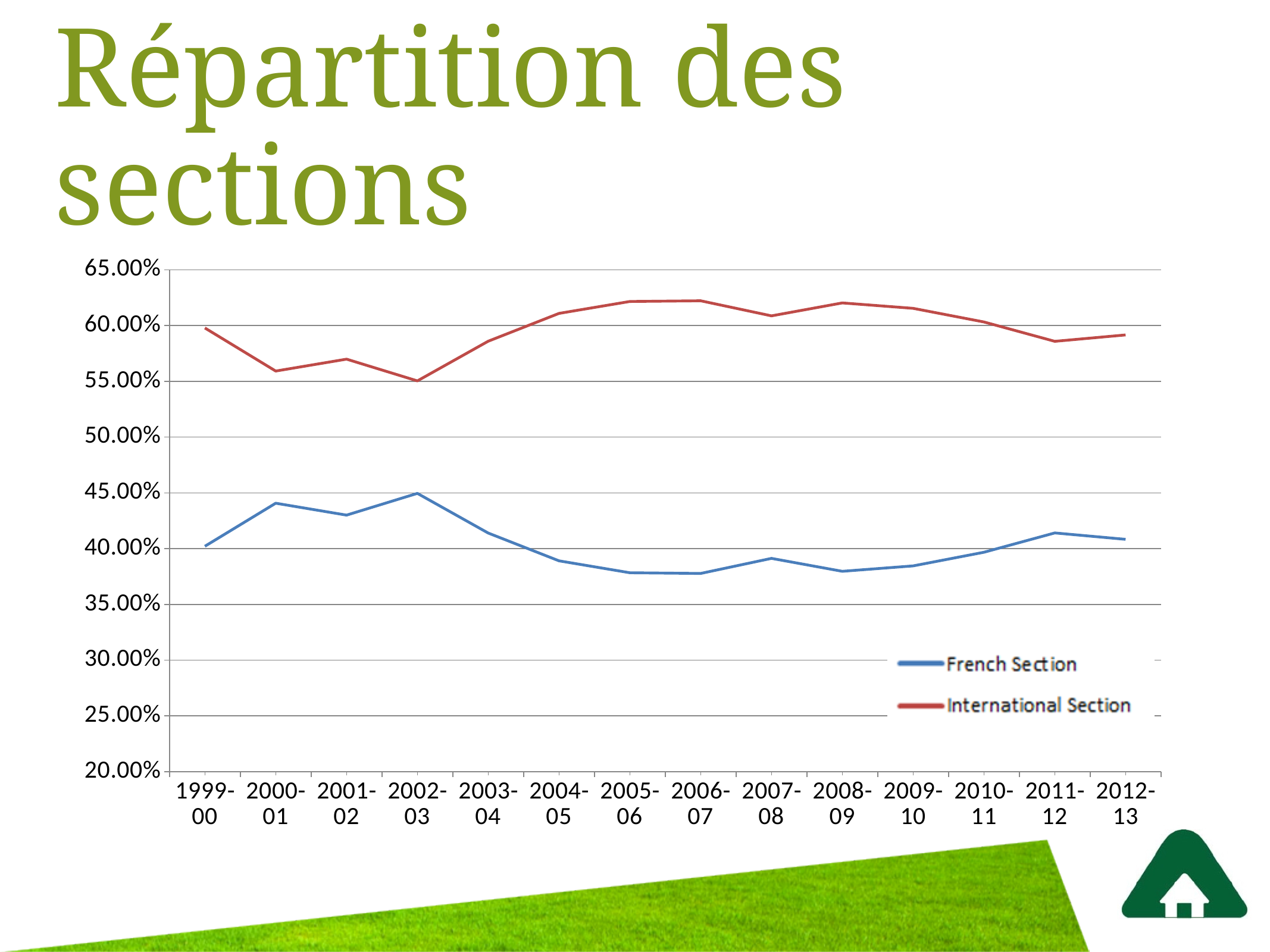
How many series does the legend list? 2 Is the value for the French Section in 2011-12 greater or less than 40.00%? greater What kind of chart is shown on the slide? Line chart In which school year does the International Section reach its lowest share? 2002-03 Is the value for the French Section in 2005-06 greater or less than 40.00%? less How many school years are plotted along the x axis? 14 In which school year does the French Section reach its highest share? 2002-03 Is the value for the International Section in 2005-06 greater or less than 60.00%? greater Which colour is used for the International Section line? Red Does the French Section share rise or fall from 2002-03 to 2005-06? Fall Which series has the larger value in 2002-03, French Section or International Section? International Section